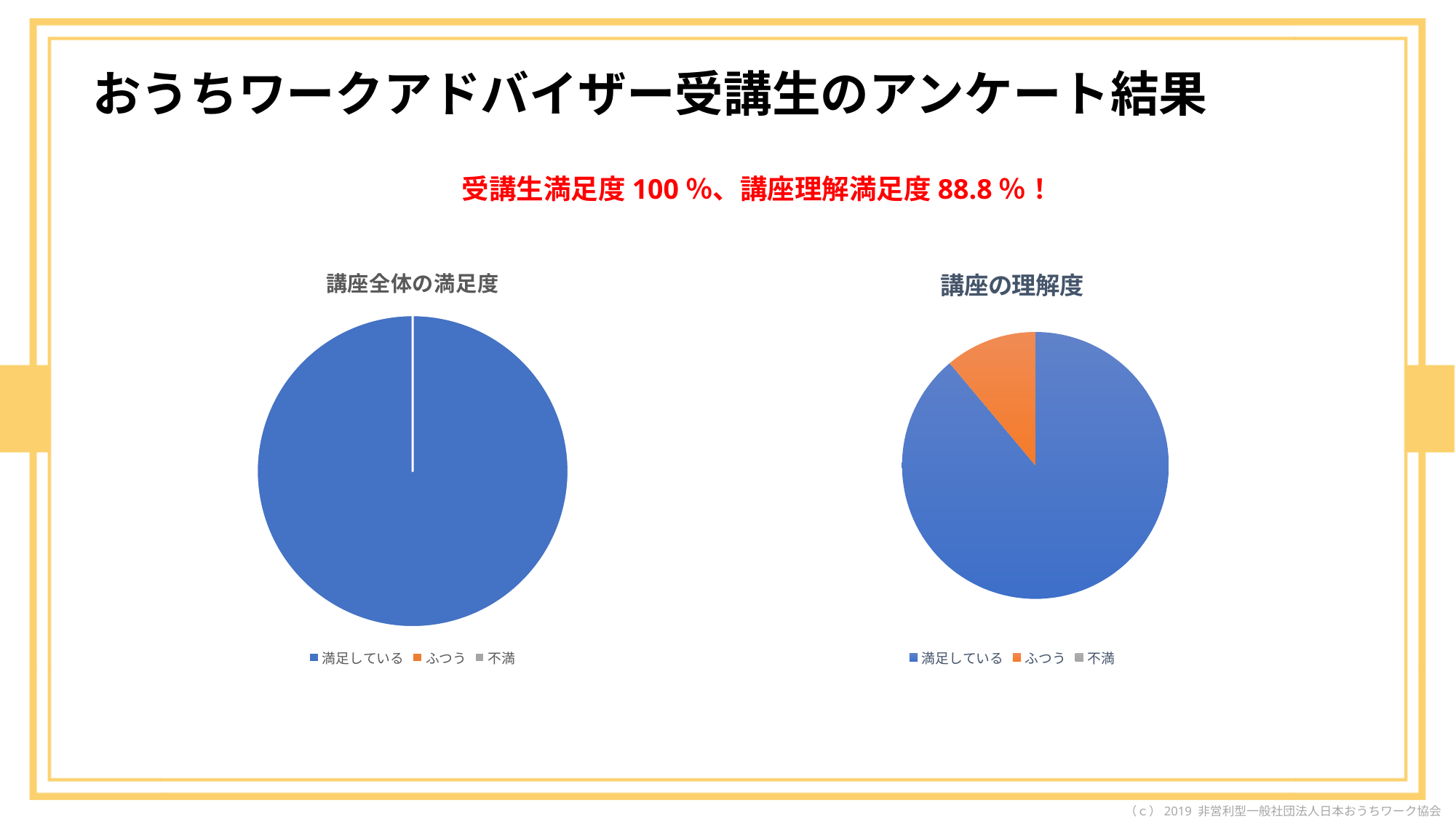
In the left chart 講座全体の満足度, which category has the largest slice? 満足している In the right chart 講座の理解度, which category has the largest slice? 満足している In the right chart 講座の理解度, what share of the pie is 満足している? 88.8% What kind of chart is the right chart titled 講座の理解度? pie chart In the left chart 講座全体の満足度, how many entries does the legend list? 3 What kind of chart is the left chart titled 講座全体の満足度? pie chart In the right chart 講座の理解度, which slice is larger, 満足している or ふつう? 満足している In the right chart 講座の理解度, how many slices are visible in the pie? 2 In the right chart 講座の理解度, how many entries does the legend list? 3 In the left chart 講座全体の満足度, what share of the pie is 満足している? 100% In the right chart 講座の理解度, what colour is the ふつう slice? orange What is the title of the left pie chart? 講座全体の満足度